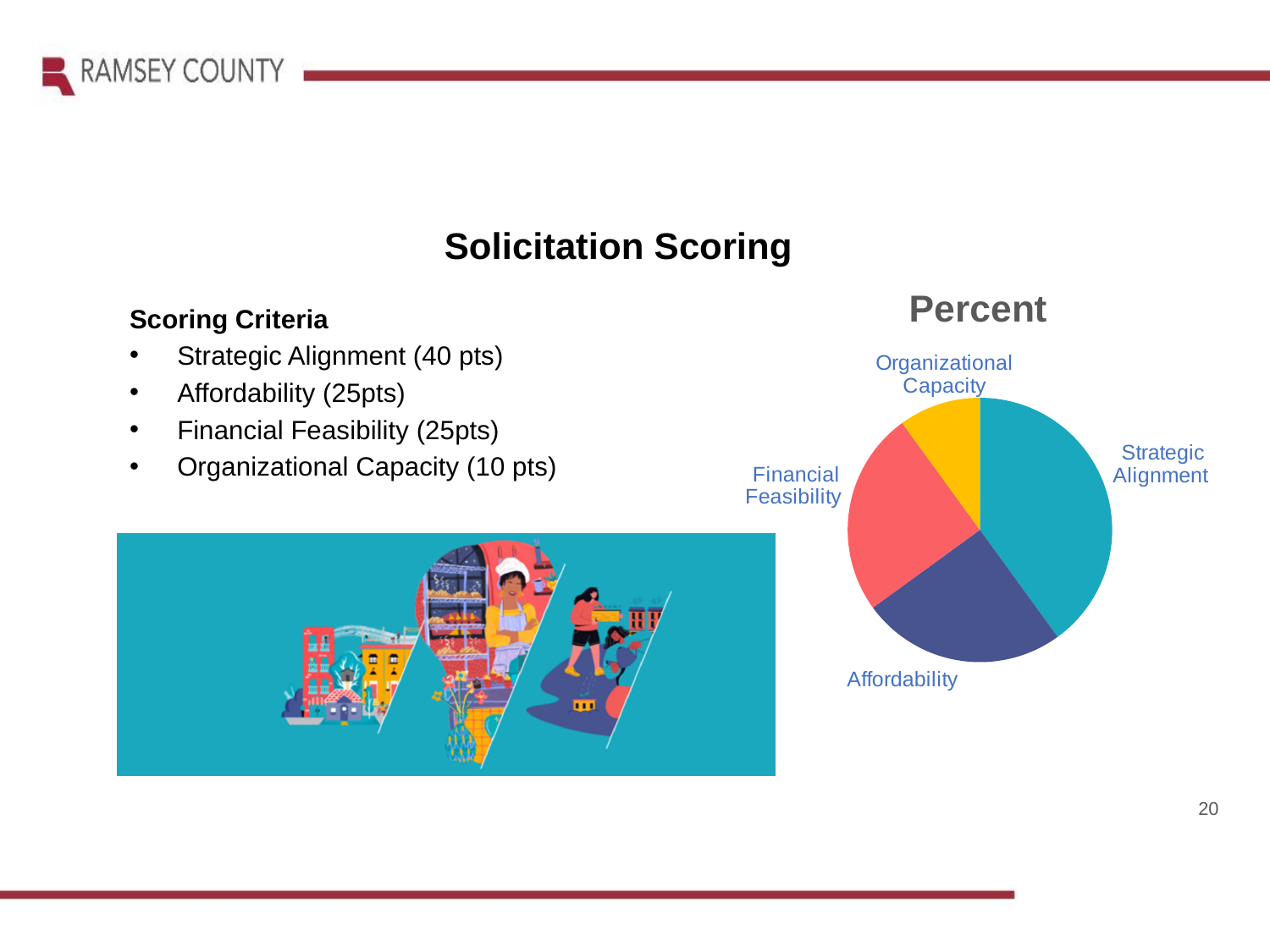
Which slice is larger, Financial Feasibility or Organizational Capacity? Financial Feasibility Which slice is larger, Affordability or Organizational Capacity? Affordability How many slices does the pie chart have? 4 What colour is the Organizational Capacity slice in the pie chart? yellow Which slice is larger, Strategic Alignment or Organizational Capacity? Strategic Alignment Which category has the largest slice in the pie chart? Strategic Alignment What is the title of the pie chart? Percent What kind of chart is shown on the slide? pie chart Which category has the smallest slice in the pie chart? Organizational Capacity